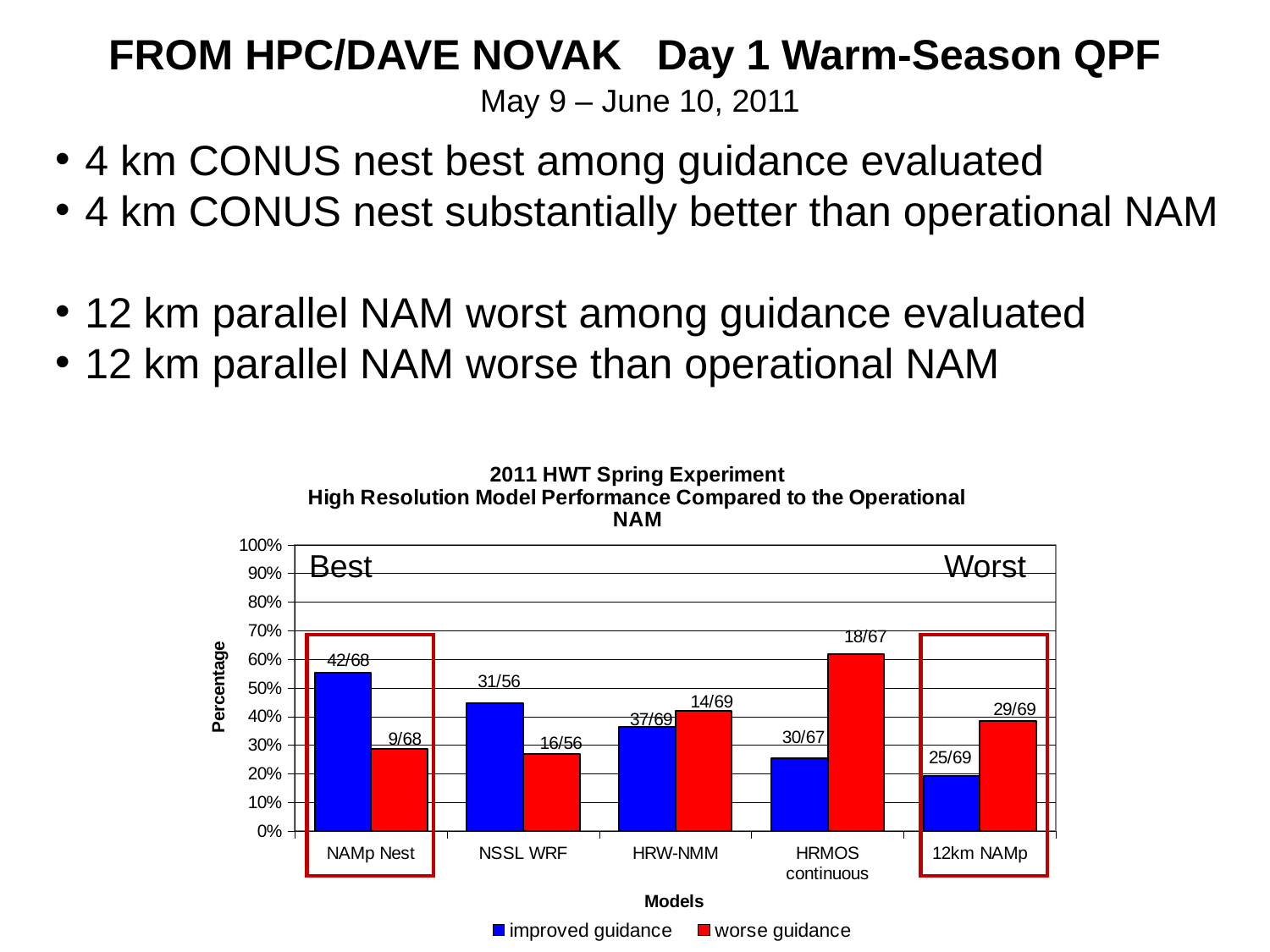
What data label is printed on the improved guidance bar for NAMp Nest? 42/68 Which model has the lowest improved guidance bar? 12km NAMp What kind of chart is shown on the slide? bar chart What data label is printed on the worse guidance bar for HRMOS continuous? 18/67 Is the worse guidance value for HRMOS continuous greater or less than 50%? greater Is the improved guidance value for NAMp Nest greater or less than 50%? greater For HRMOS continuous, which is larger: the improved guidance bar or the worse guidance bar? worse guidance How many models are shown along the x axis of the chart? 5 What data label is printed on the worse guidance bar for NSSL WRF? 16/56 How many series does the chart's legend list? 2 Which model has the highest improved guidance bar? NAMp Nest What data label is printed on the improved guidance bar for 12km NAMp? 25/69